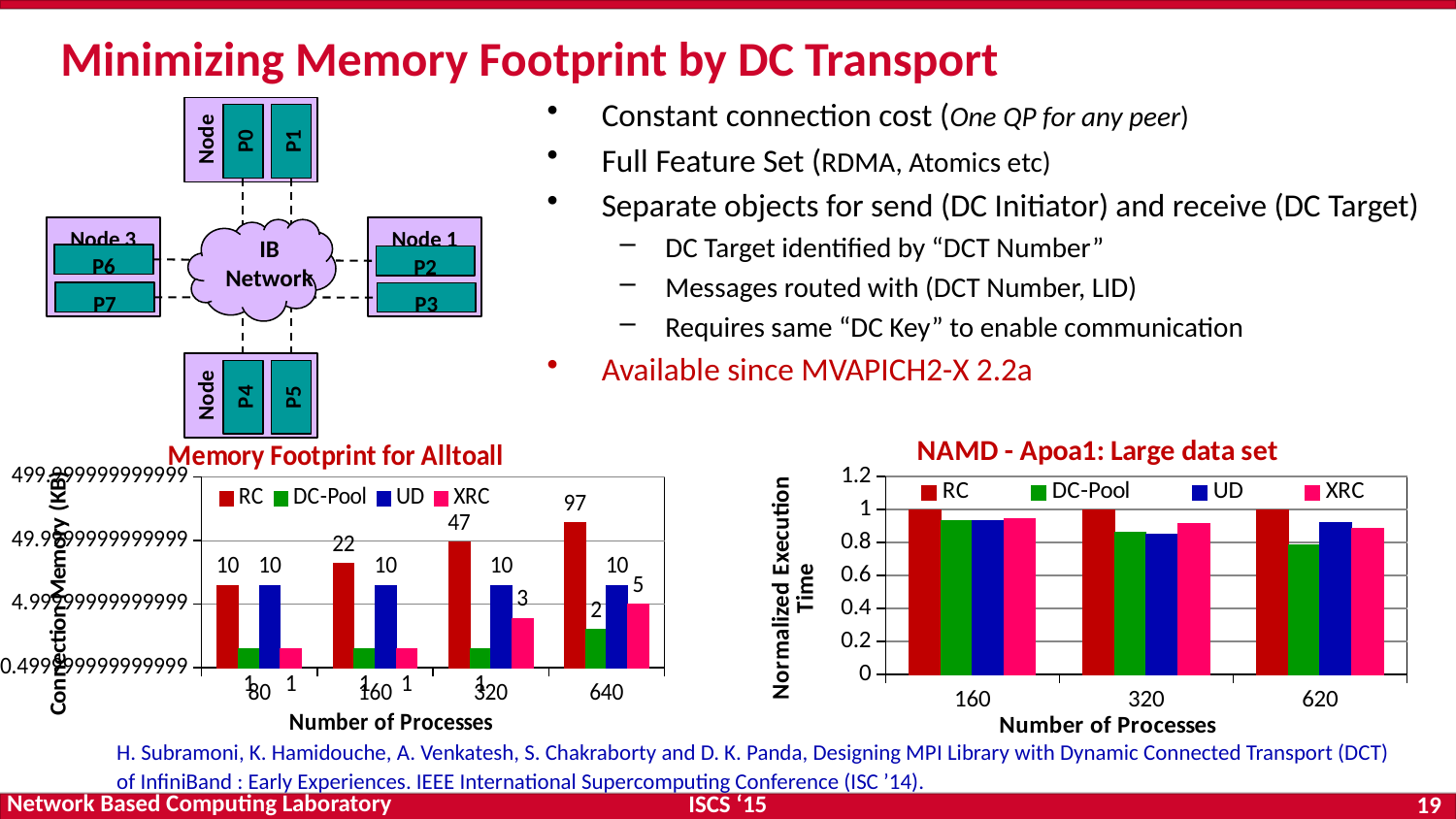
What kind of chart is the NAMD - Apoa1: Large data set chart? Bar chart In the Memory Footprint for Alltoall chart, which series has the highest value at 640 processes? RC In the Memory Footprint for Alltoall chart, how many process counts are shown on the x axis? 4 In the Memory Footprint for Alltoall chart, what is the difference between RC and UD at 320 processes? 37 In the NAMD - Apoa1: Large data set chart, is the value for UD at 320 processes greater or less than 1? less In the Memory Footprint for Alltoall chart, what is the value for UD at 320 processes? 10 In the NAMD - Apoa1: Large data set chart, how many series does the legend list? 4 In the Memory Footprint for Alltoall chart, how does the RC value change as the number of processes increases? It rises In the Memory Footprint for Alltoall chart, what is the value for RC at 160 processes? 22 In the Memory Footprint for Alltoall chart, what is the value for XRC at 640 processes? 5 In the Memory Footprint for Alltoall chart, what is the value for RC at 640 processes? 97 In the Memory Footprint for Alltoall chart, which is larger at 640 processes, XRC or DC-Pool? XRC